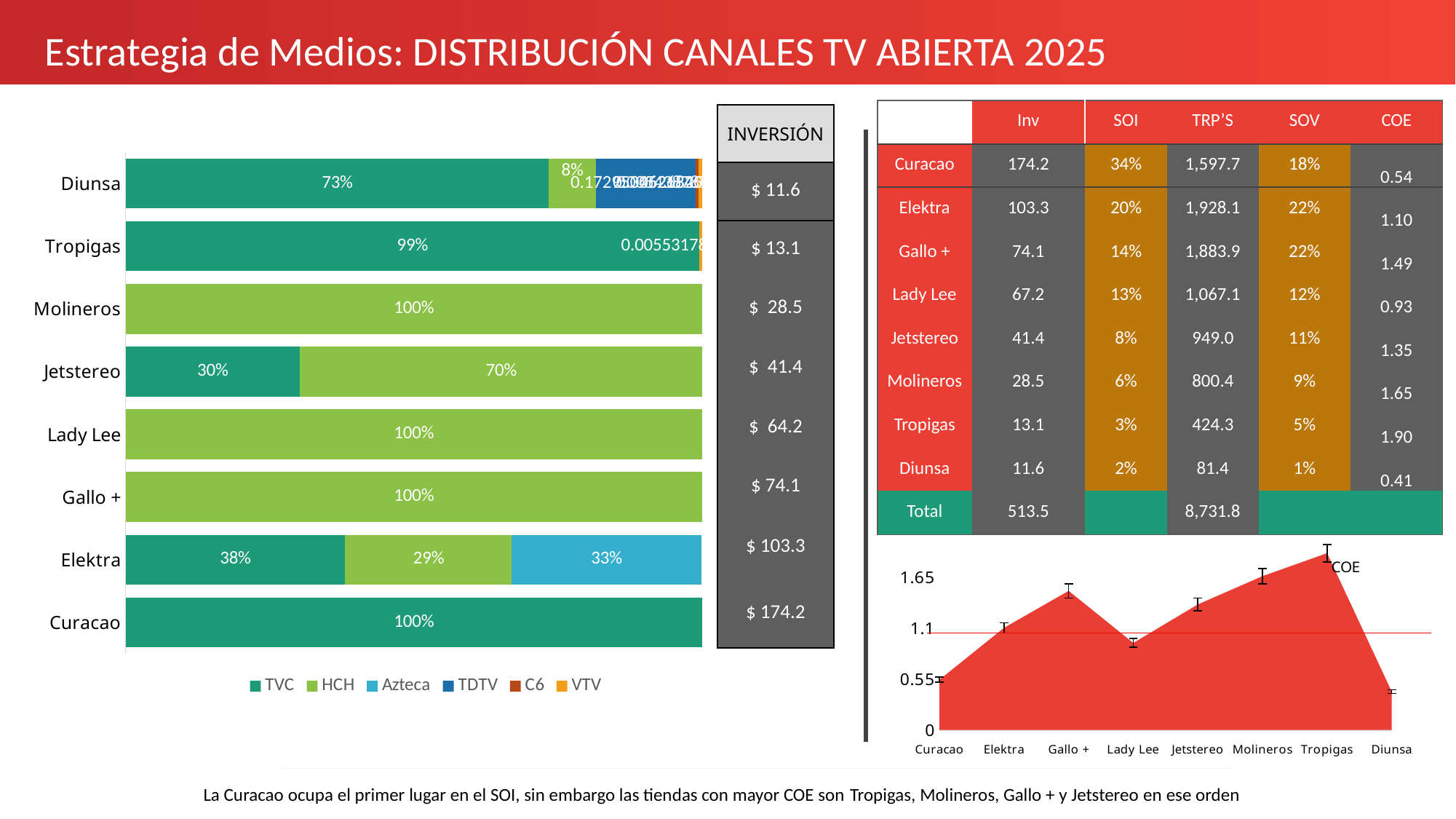
In the left bar chart, how many series does the legend list? 6 In the COE chart at the bottom right, is the value for Curacao greater or less than 1.1? less In the left bar chart, what is the HCH share for Jetstereo? 70% In the left bar chart, how many stores (categories) are plotted? 8 In the left bar chart, what is the TVC share for Elektra? 38% In the left bar chart, for Jetstereo, which is larger: the TVC share or the HCH share? HCH What kind of chart is the chart on the left showing the channel distribution by store? Stacked bar chart In the COE chart at the bottom right, which store has the lowest value? Diunsa In the left bar chart, what is the Azteca share for Elektra? 33% In the left bar chart, what is the TVC share for Diunsa? 73% In the left bar chart, what is the difference between Elektra's TVC share and its Azteca share? 5% In the COE chart at the bottom right, which store has the highest value? Tropigas